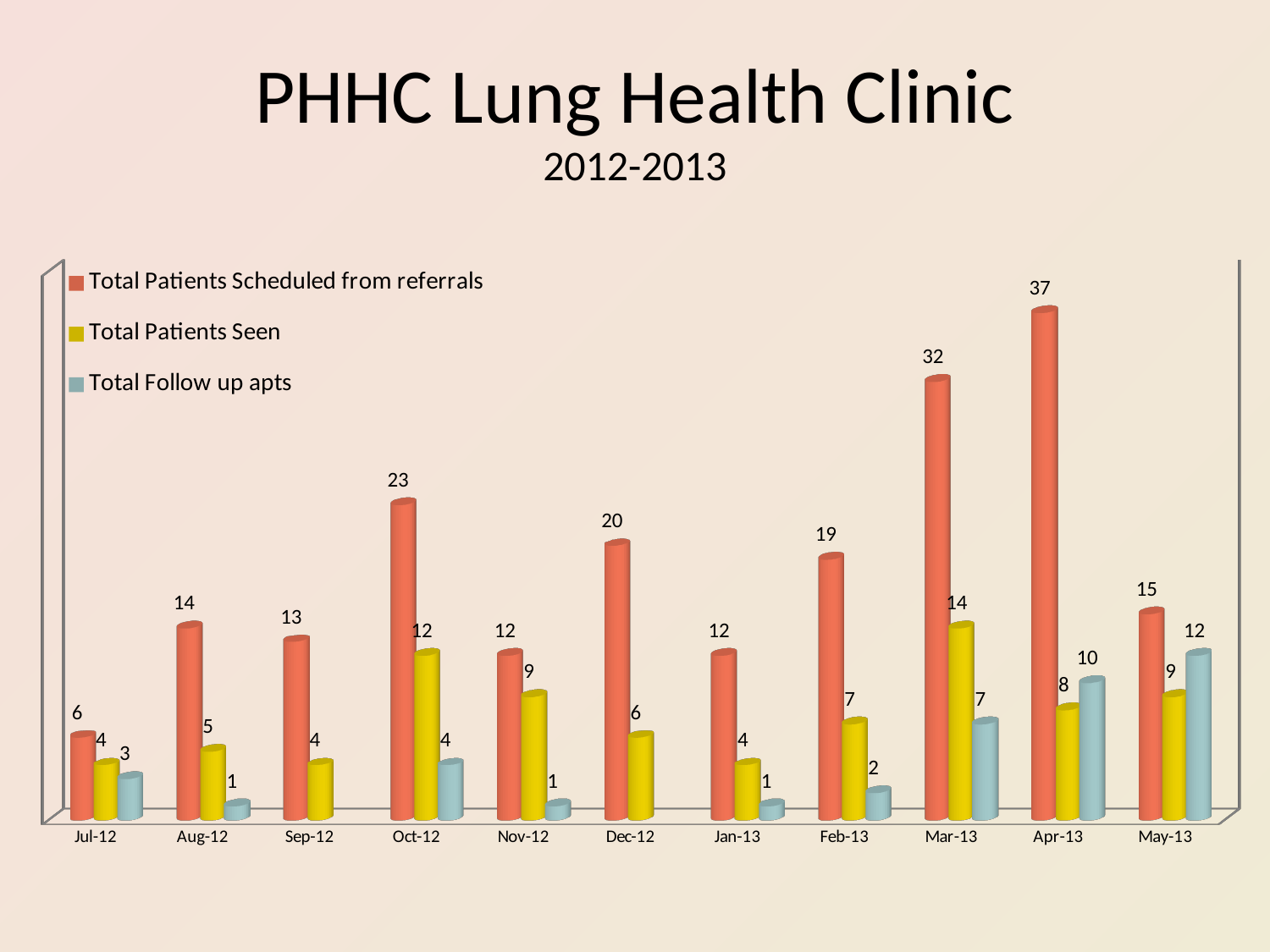
Which month has the lowest value for Total Patients Scheduled from referrals? Jul-12 What colour are the bars for Total Patients Seen? Yellow How many months are shown on the x axis? 11 Which is larger in Apr-13: Total Patients Seen or Total Follow up apts? Total Follow up apts What is the value for Total Patients Scheduled from referrals in Apr-13? 37 Which month has the highest value for Total Patients Seen? Mar-13 What is the value for Total Patients Seen in Oct-12? 12 How many series does the legend list? 3 Which month has the highest value for Total Patients Scheduled from referrals? Apr-13 What is the value for Total Follow up apts in May-13? 12 What kind of chart is shown on the slide? Bar chart What is the difference between Total Patients Scheduled from referrals and Total Patients Seen in Mar-13? 18